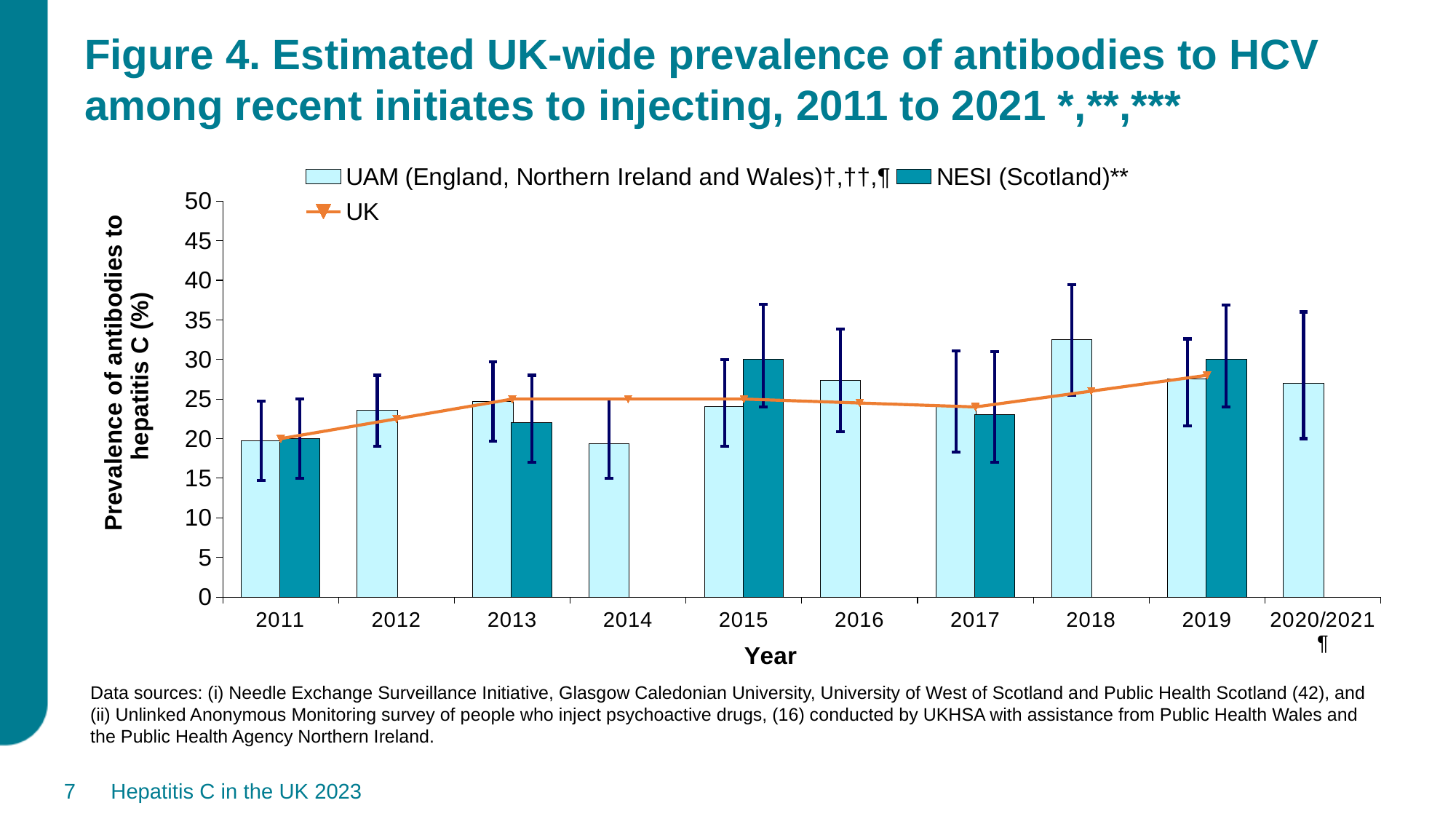
Is the UK value for 2011 greater or less than 25? less What kind of chart is shown on the slide? combination bar and line chart How many year categories are shown on the x axis? 10 In which year is the UAM (England, Northern Ireland and Wales) bar highest? 2018 In which year is the NESI (Scotland) bar lowest? 2011 How many series does the legend list? 3 Is the UAM (England, Northern Ireland and Wales) value for 2018 greater or less than 30? greater What is the title of the y axis? Prevalence of antibodies to hepatitis C (%) Does the UK line rise or fall overall from 2011 to 2019? rise Is the UAM (England, Northern Ireland and Wales) value for 2014 greater or less than 20? less Which is larger, the UAM (England, Northern Ireland and Wales) value for 2016 or for 2014? 2016